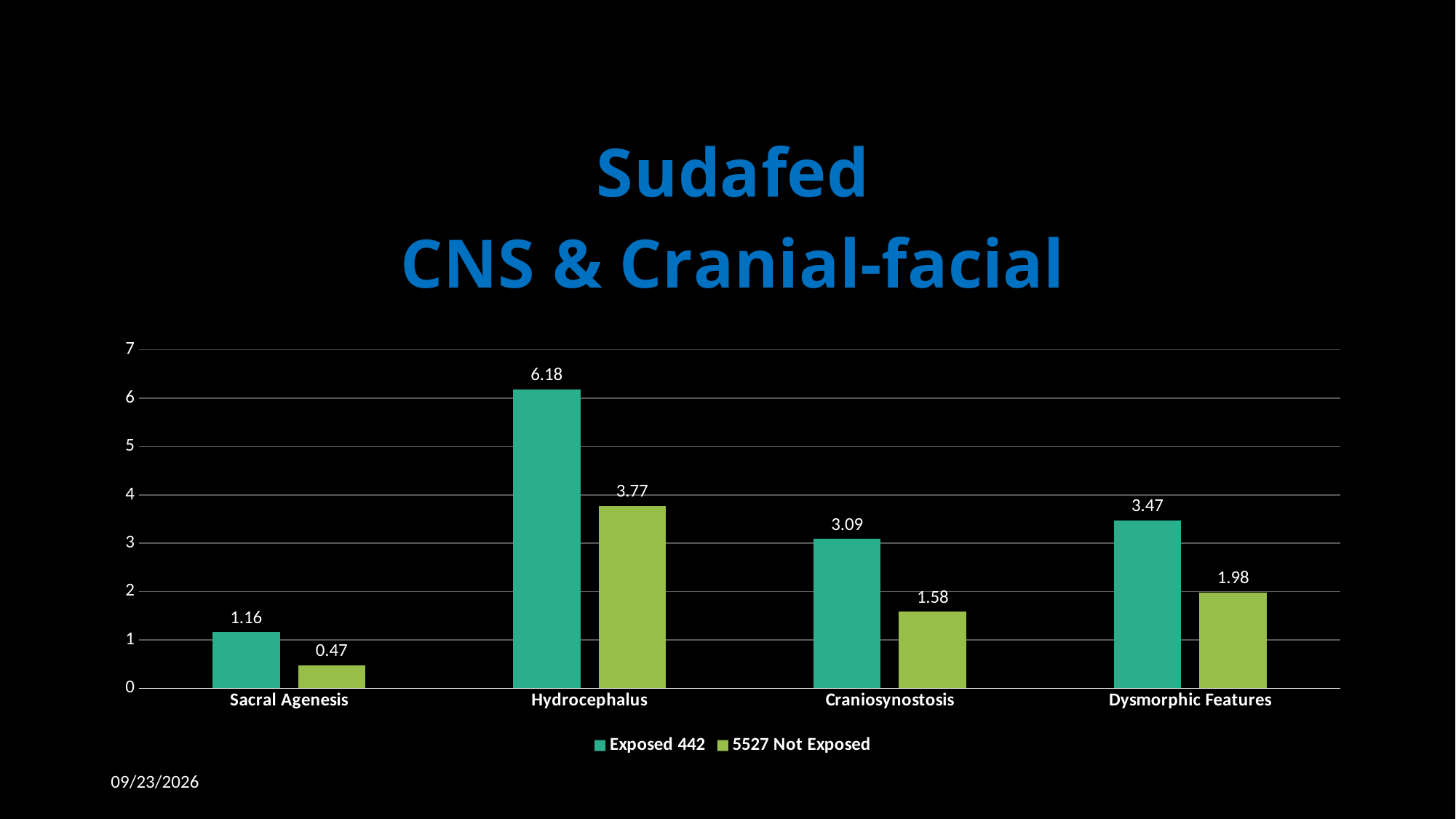
What is the difference between the Exposed 442 and 5527 Not Exposed values for Craniosynostosis? 1.51 What is the value for Sacral Agenesis in the 5527 Not Exposed series? 0.47 Which category has the highest value in the Exposed 442 series? Hydrocephalus What kind of chart is shown on the slide? bar chart What is the difference between the Exposed 442 and 5527 Not Exposed values for Hydrocephalus? 2.41 How many categories are shown on the x axis? 4 Which is larger: the Exposed 442 value for Dysmorphic Features or the Exposed 442 value for Craniosynostosis? Dysmorphic Features Is the Exposed 442 value for Hydrocephalus greater or less than 5? greater Which category has the lowest value in the 5527 Not Exposed series? Sacral Agenesis What is the value for Dysmorphic Features in the 5527 Not Exposed series? 1.98 What is the value for Hydrocephalus in the Exposed 442 series? 6.18 How many series does the legend list? 2